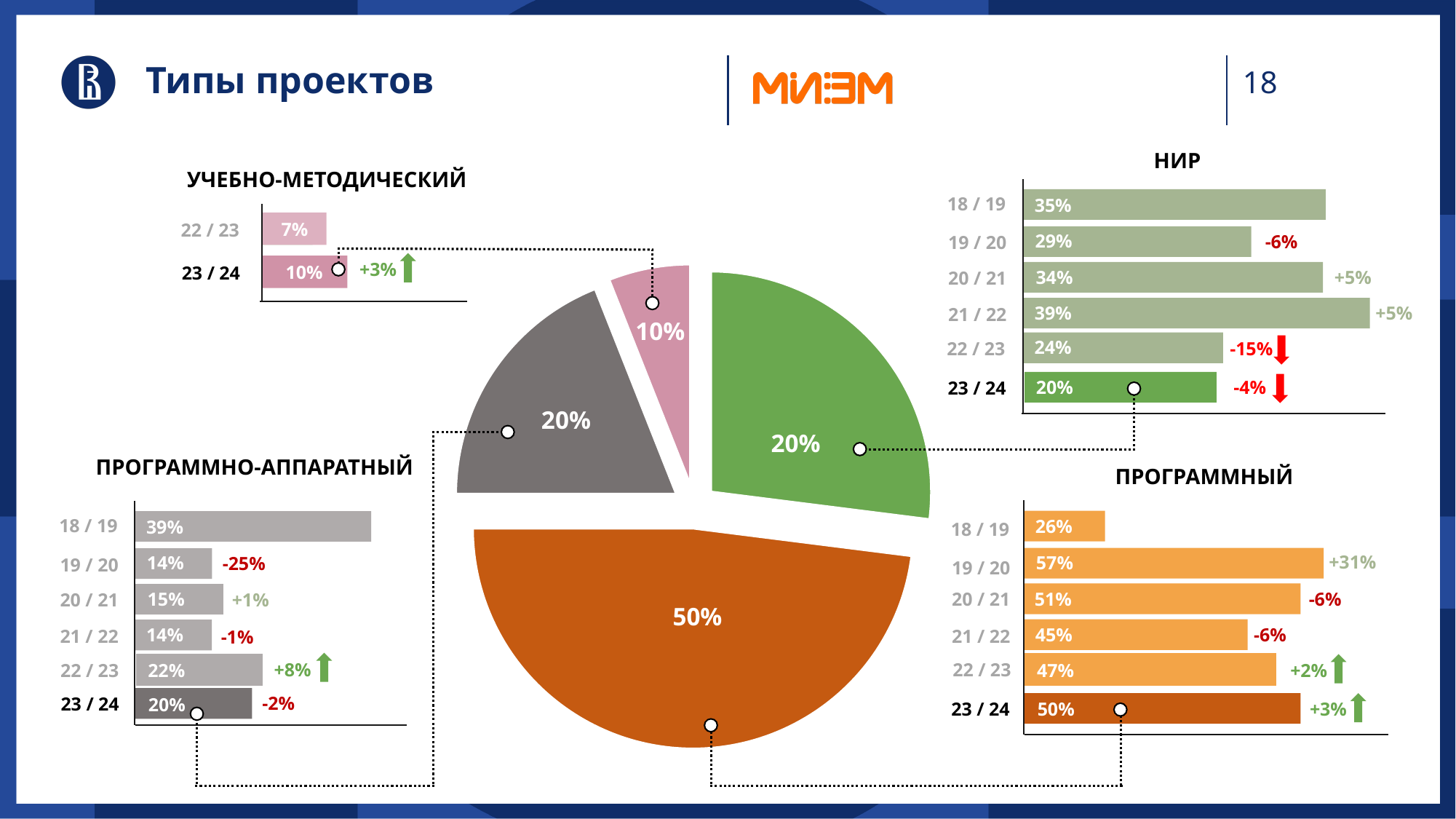
In the ПРОГРАММНО-АППАРАТНЫЙ bar chart, what is the value for 22 / 23? 22% In the НИР bar chart, what is the difference between the 21 / 22 value and the 23 / 24 value? 19% In the central pie chart, what share does the largest slice (orange) have? 50% What type of chart is the ПРОГРАММНЫЙ chart? bar chart In the НИР bar chart, what is the value for 18 / 19? 35% In the central pie chart, what share does the pink slice have? 10% In the УЧЕБНО-МЕТОДИЧЕСКИЙ bar chart, how many bars are shown? 2 How many slices does the central pie chart have? 4 In the ПРОГРАММНЫЙ bar chart, which year has the lowest value? 18 / 19 In the ПРОГРАММНЫЙ bar chart, what is the value for 19 / 20? 57% In the НИР bar chart, which year has the highest value? 21 / 22 In the ПРОГРАММНО-АППАРАТНЫЙ bar chart, which is larger: the value for 18 / 19 or the value for 23 / 24? 18 / 19